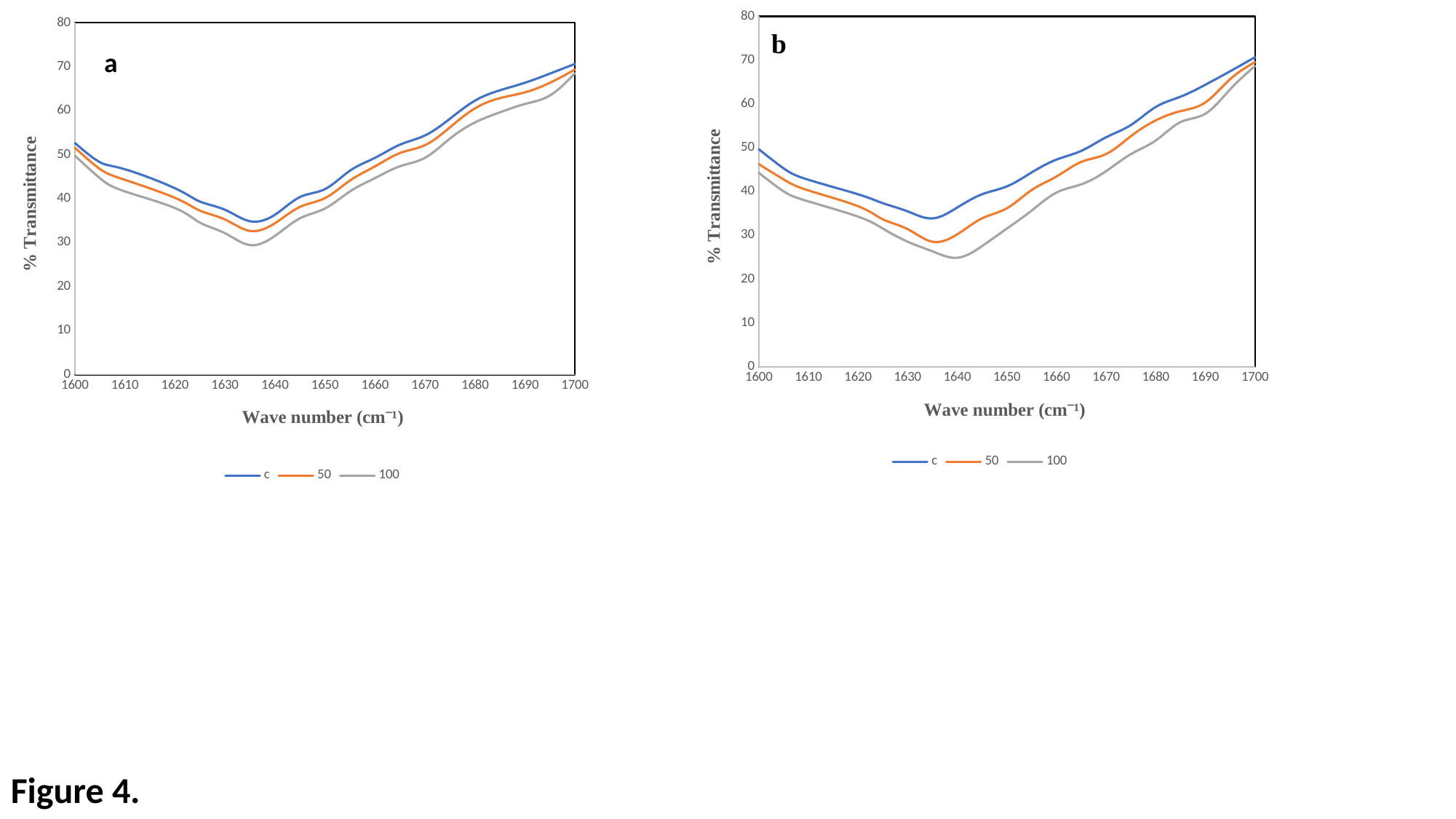
What colour is the line for series 50 in chart a (the left chart)? orange In chart b (the right chart), is the lowest value of series 100 greater or less than 30? less In chart a (the left chart), is the value of series c at 1600 greater or less than 40? greater In chart b (the right chart), is the value of series c at 1700 greater or less than 60? greater In chart b (the right chart), which series has the higher value at 1640, 50 or 100? 50 What is the y-axis title of chart b (the right chart)? % Transmittance In chart a (the left chart), do the values of series c rise or fall between 1640 and 1700? rise In chart b (the right chart), do the values of series 100 rise or fall between 1600 and 1630? fall How many series does the legend of chart b (the right chart) list? 3 In chart a (the left chart), which series has the higher value at 1640, c or 100? c What kind of chart is chart a (the left chart)? line chart